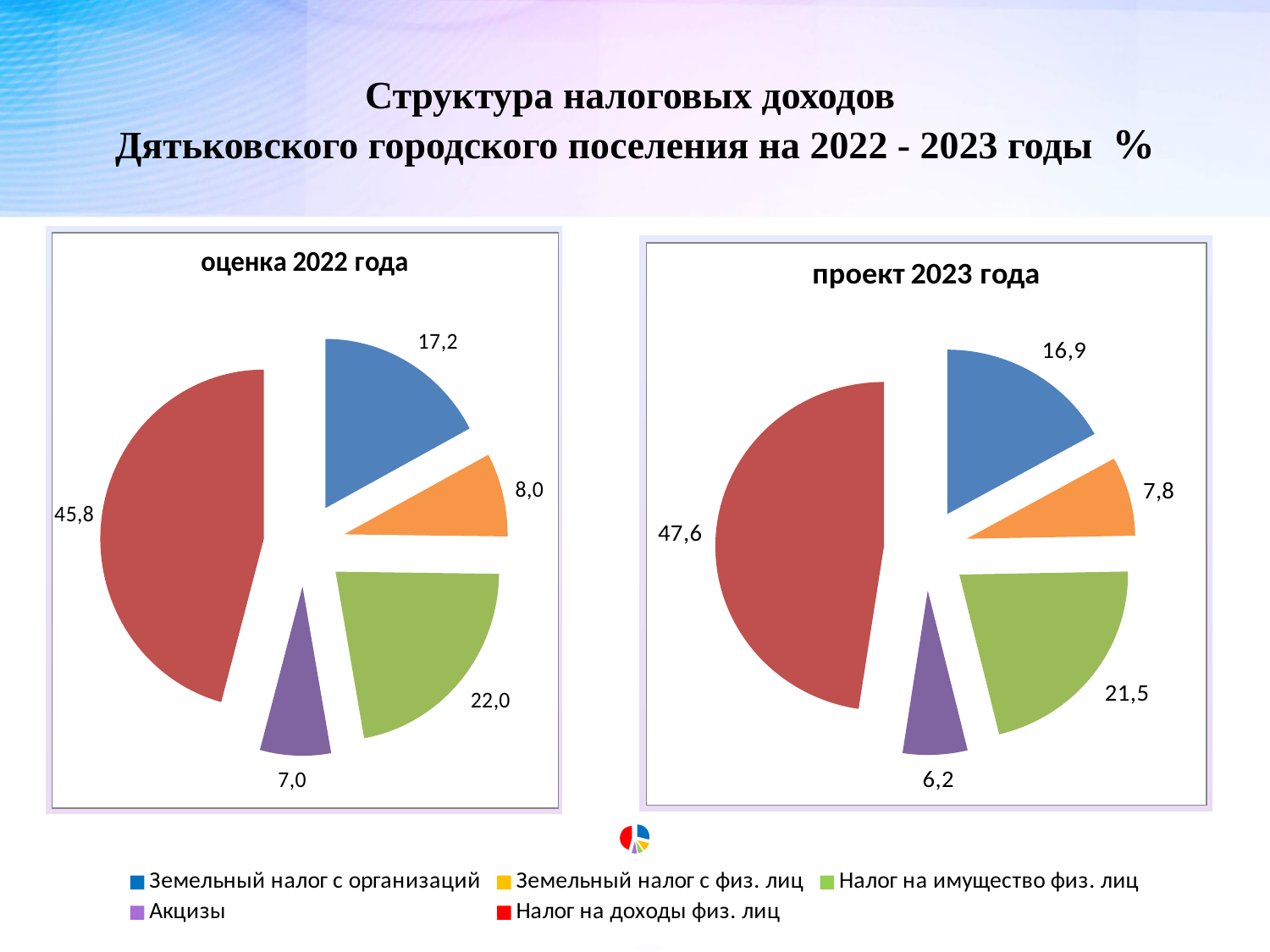
In the chart titled "оценка 2022 года", what is the difference between Налог на имущество физ. лиц and Земельный налог с организаций? 4,8 How many slices does the chart titled "оценка 2022 года" have? 5 In the chart titled "оценка 2022 года", what is the value for Налог на доходы физ. лиц? 45,8 Which colour represents Акцизы in the legend? Purple What type of chart is the chart titled "проект 2023 года"? Pie chart In the chart titled "проект 2023 года", what is the value for Земельный налог с организаций? 16,9 In the chart titled "оценка 2022 года", which category has the smallest slice? Акцизы In the chart titled "проект 2023 года", what is the difference between Налог на доходы физ. лиц and Налог на имущество физ. лиц? 26,1 In the chart titled "проект 2023 года", what is the value for Налог на имущество физ. лиц? 21,5 In the chart titled "оценка 2022 года", what is the value for Акцизы? 7,0 In the chart titled "проект 2023 года", which category has the largest slice? Налог на доходы физ. лиц In the chart titled "проект 2023 года", which is larger: Земельный налог с физ. лиц or Акцизы? Земельный налог с физ. лиц